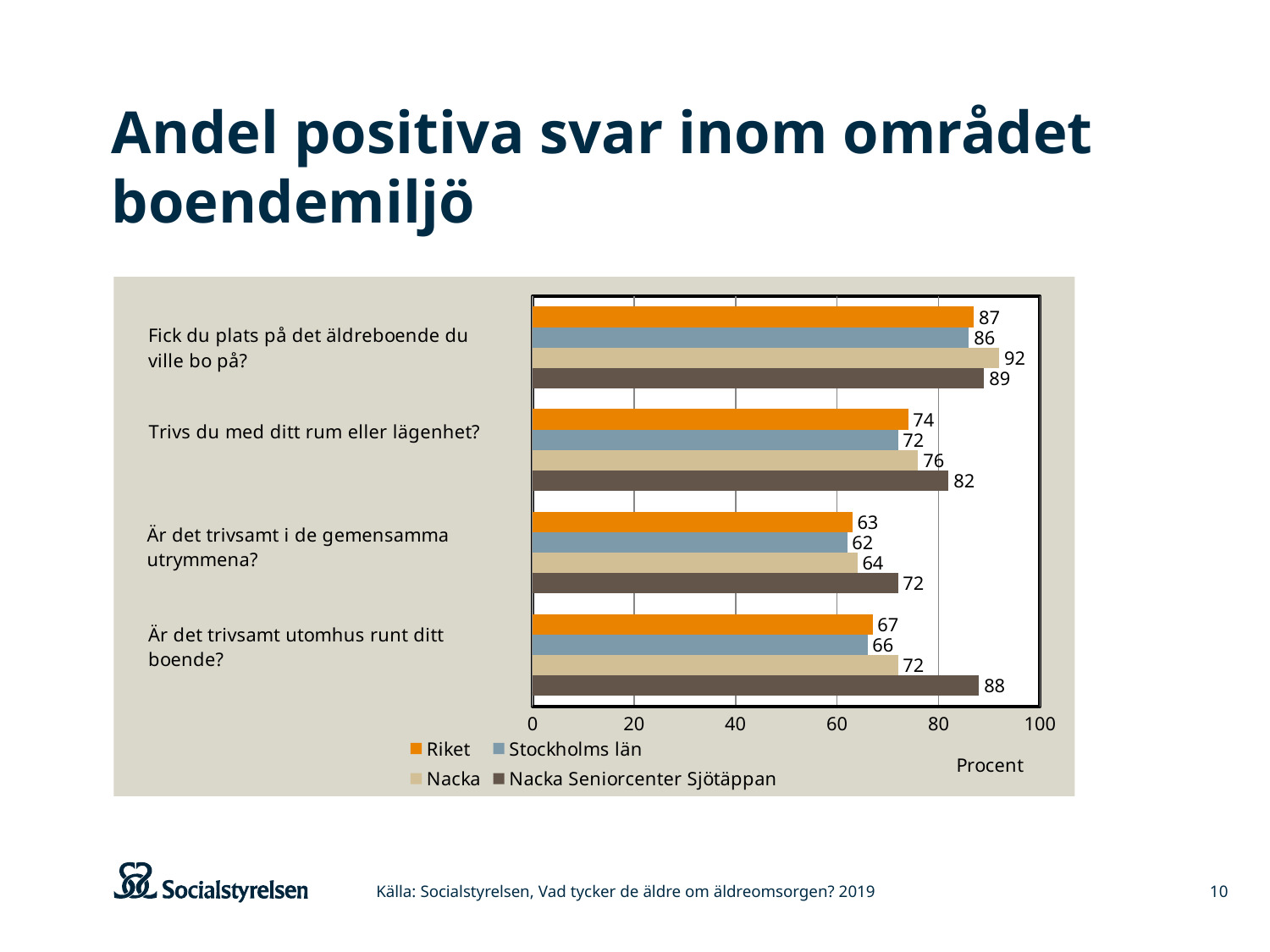
Which question has the highest value for Nacka? Fick du plats på det äldreboende du ville bo på? How many questions (categories) are shown on the chart? 4 What is the value for Nacka on "Är det trivsamt i de gemensamma utrymmena?"? 64 What is the label on the horizontal axis of the chart? Procent How many series does the legend list? 4 Which question has the lowest value for Riket? Är det trivsamt i de gemensamma utrymmena? What is the value for Nacka Seniorcenter Sjötäppan on "Är det trivsamt utomhus runt ditt boende?"? 88 What kind of chart is shown on the slide? Bar chart What is the value for Riket on "Trivs du med ditt rum eller lägenhet?"? 74 What is the value for Stockholms län on "Fick du plats på det äldreboende du ville bo på?"? 86 What is the difference between Nacka Seniorcenter Sjötäppan and Riket on "Är det trivsamt utomhus runt ditt boende?"? 21 On "Fick du plats på det äldreboende du ville bo på?", which is larger: Nacka or Nacka Seniorcenter Sjötäppan? Nacka